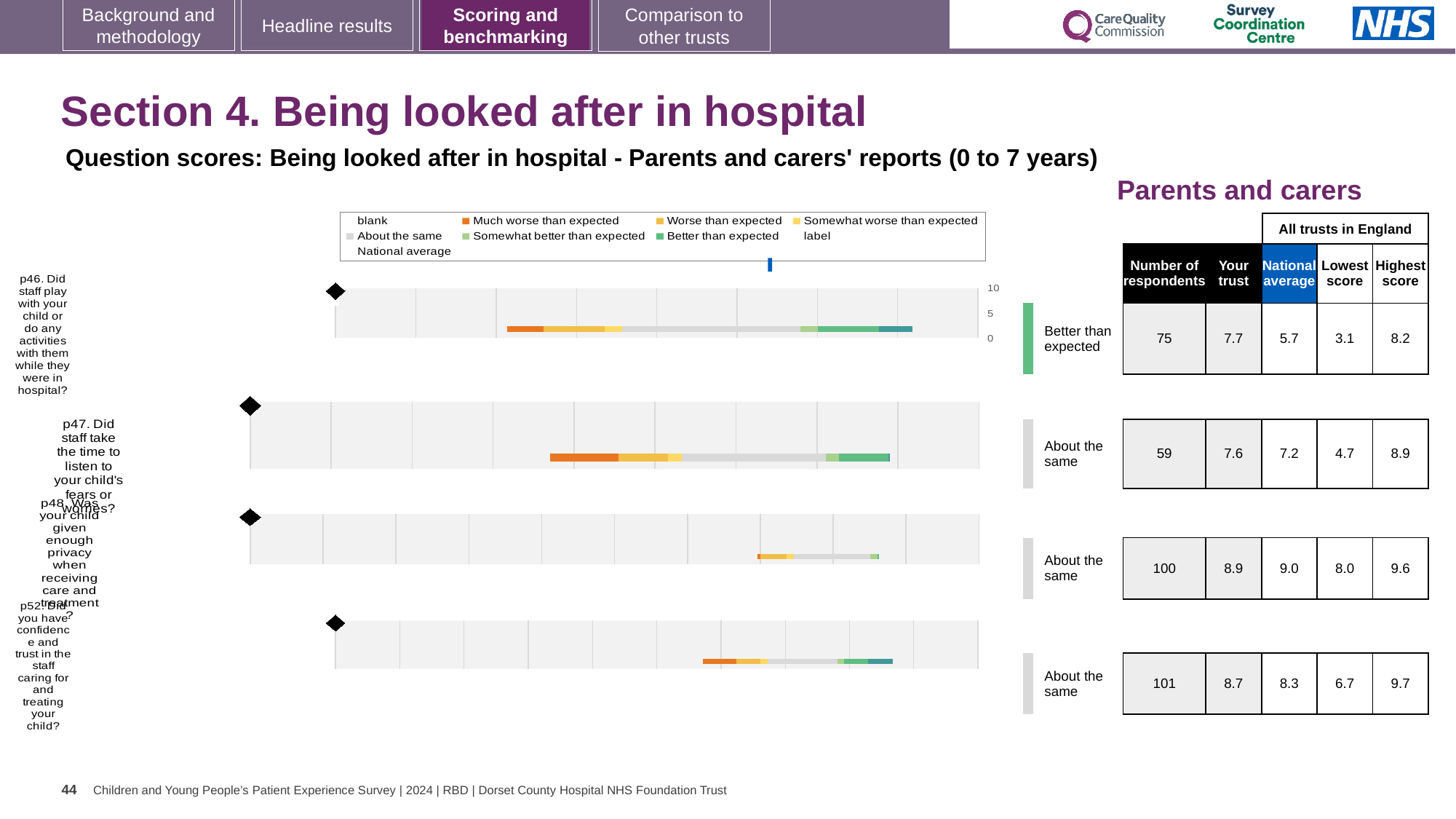
For p46, what is the difference between the 'Your trust' score and the national average in the table beside the chart? 2.0 In the table beside the chart, what is the national average for p47 (Did staff take the time to listen to your child's fears or worries?)? 7.2 How many of the four questions are labelled 'About the same' next to the chart? 3 For p48, which is larger in the table beside the chart: the 'Your trust' score or the national average? National average Which question has the lowest number of respondents in the table beside the chart? p47. Did staff take the time to listen to your child's fears or worries? In the table beside the chart, what is the highest score across all trusts in England for p48 (Was your child given enough privacy when receiving care and treatment?)? 9.6 Which question has the highest 'Your trust' score in the table beside the chart? p48. Was your child given enough privacy when receiving care and treatment? In the table beside the chart, what is the 'Your trust' score for p46 (Did staff play with your child or do any activities with them while they were in hospital?)? 7.7 In the table beside the chart, how many respondents answered p52 (Did you have confidence and trust in the staff caring for and treating your child?)? 101 What kind of chart is used to show the question scores on this slide? bar chart How many survey questions (bars) are shown in the chart? 4 What benchmark label is shown next to the bar for p46? Better than expected